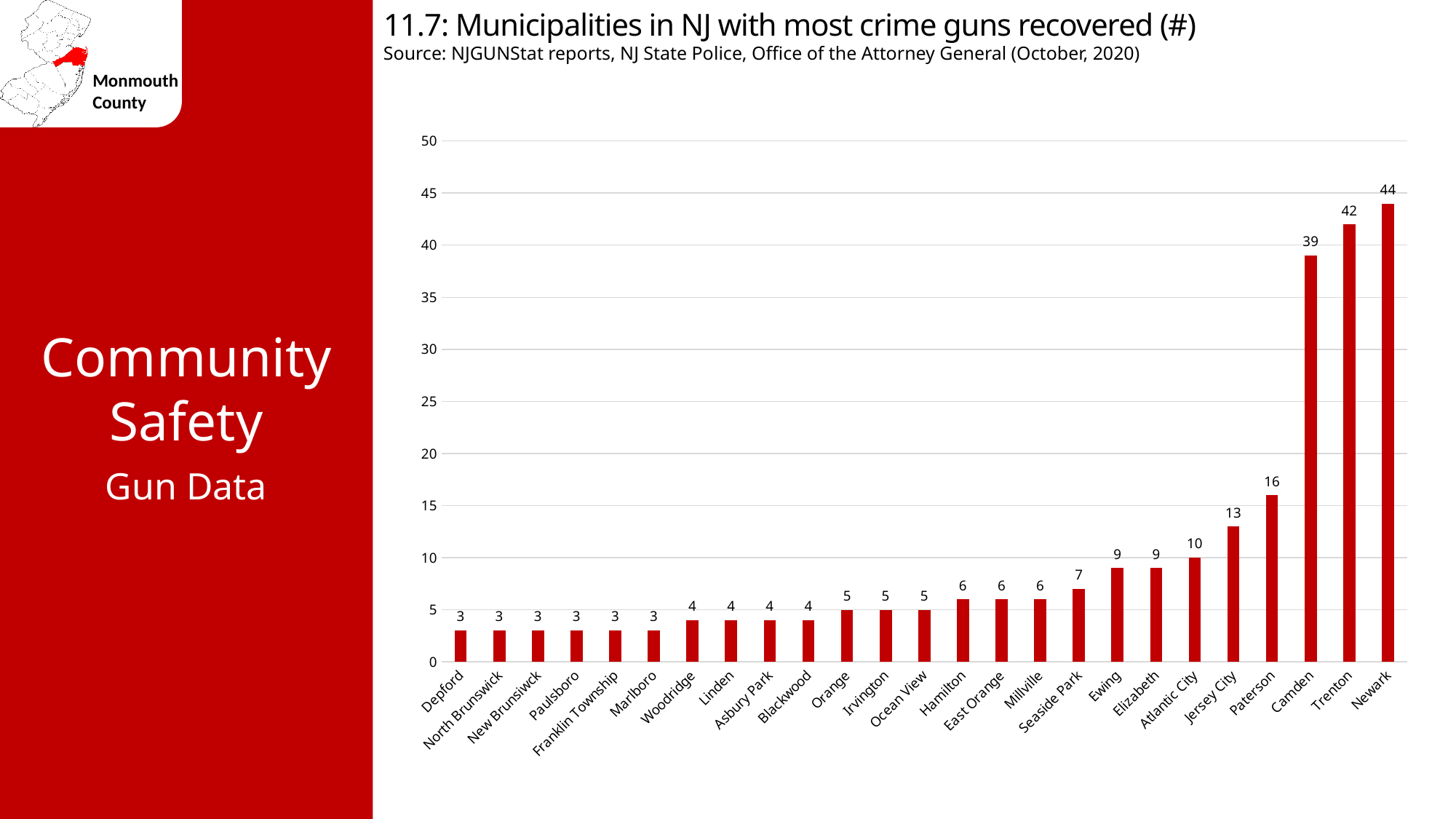
What is the value for Asbury Park? 4 What is the difference between the values for Newark and Trenton? 2 Which municipality has the highest number of crime guns recovered? Newark Which is larger, the value for Camden or the value for Paterson? Camden What is the value for Camden? 39 Is the value for Trenton greater or less than 40? greater What is the value for Newark? 44 What is the value for Jersey City? 13 Do the values generally rise or fall from left to right along the x axis? Rise How many municipalities are shown on the chart? 25 What is the difference between the values for Paterson and Atlantic City? 6 What kind of chart is shown on the slide? Bar chart